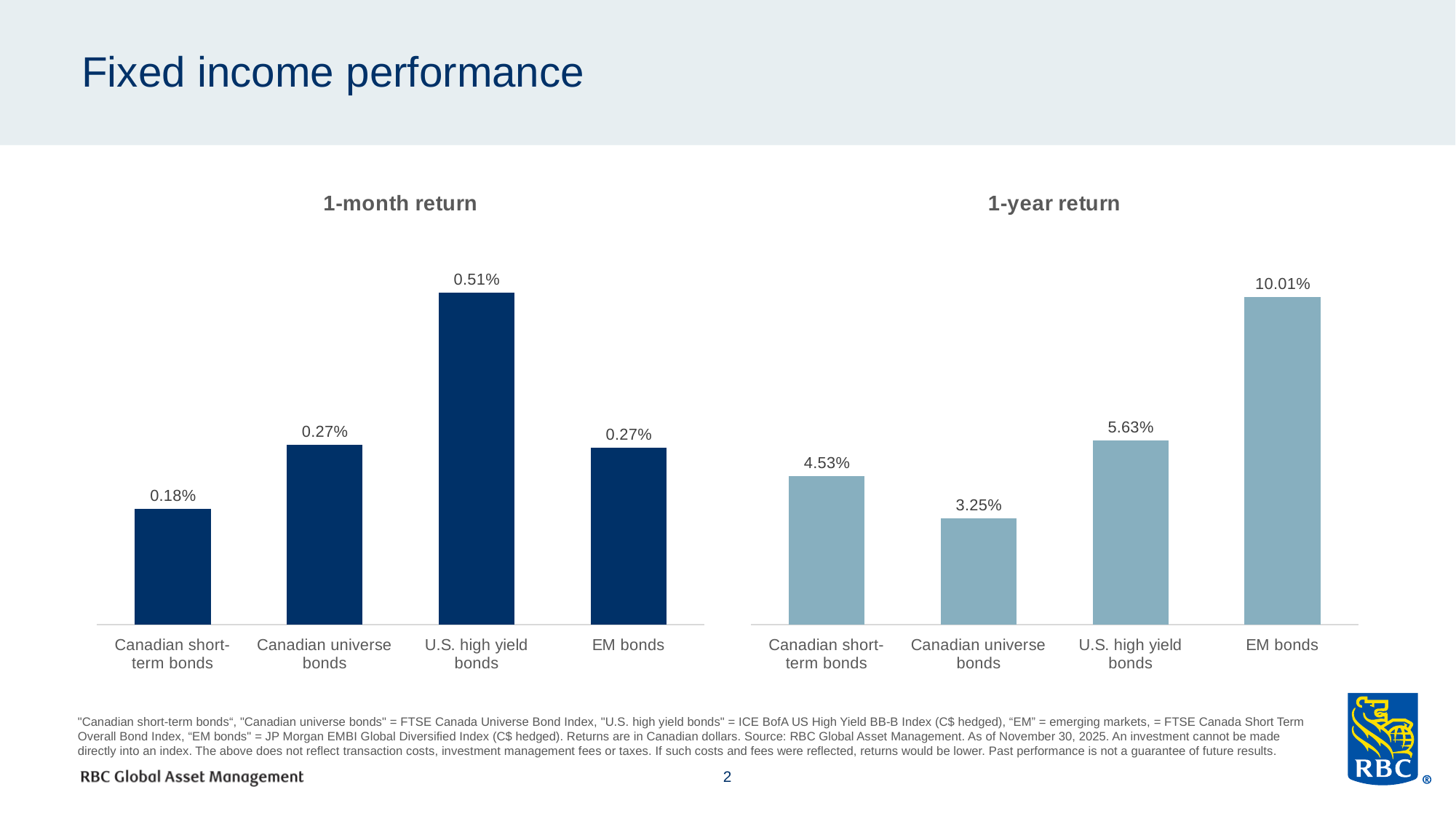
In the 1-year return chart, which is larger: Canadian short-term bonds or Canadian universe bonds? Canadian short-term bonds In the 1-year return chart, what is the value for Canadian universe bonds? 3.25% In the 1-month return chart, what is the value for Canadian short-term bonds? 0.18% What is the title of the chart on the left side of the slide? 1-month return In the 1-year return chart, which category has the highest value? EM bonds In the 1-year return chart, which category has the lowest value? Canadian universe bonds In the 1-month return chart, what is the value for U.S. high yield bonds? 0.51% How many categories are shown in the 1-month return chart? 4 What kind of chart is the 1-year return chart? Bar chart In the 1-month return chart, what is the difference between U.S. high yield bonds and Canadian universe bonds? 0.24% In the 1-year return chart, what is the difference between EM bonds and U.S. high yield bonds? 4.38% In the 1-month return chart, which category has the lowest value? Canadian short-term bonds